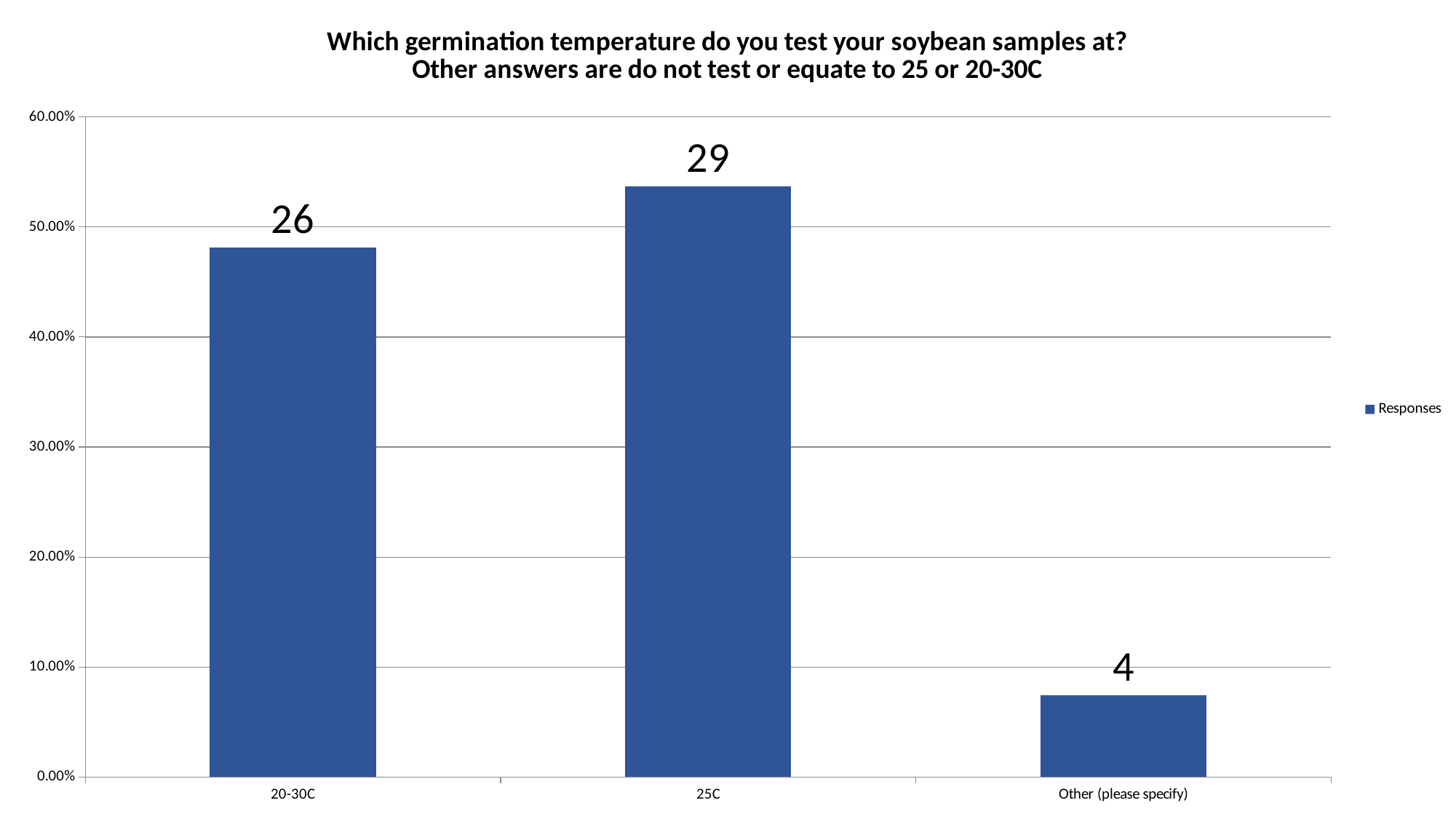
What is the data label shown on the bar for Other (please specify)? 4 What is the difference between the data labels for 25C and 20-30C? 3 Is the value for Other (please specify) greater or less than 10.00%? less What is the data label shown on the bar for 25C? 29 Which category has the highest bar? 25C What is the data label shown on the bar for 20-30C? 26 Is the value for 20-30C greater or less than 40.00%? greater Which category has the lowest bar? Other (please specify) How many categories are shown on the x axis? 3 How many series does the legend list? 1 What kind of chart is shown on the slide? bar chart Which is larger, the bar for 20-30C or the bar for Other (please specify)? 20-30C